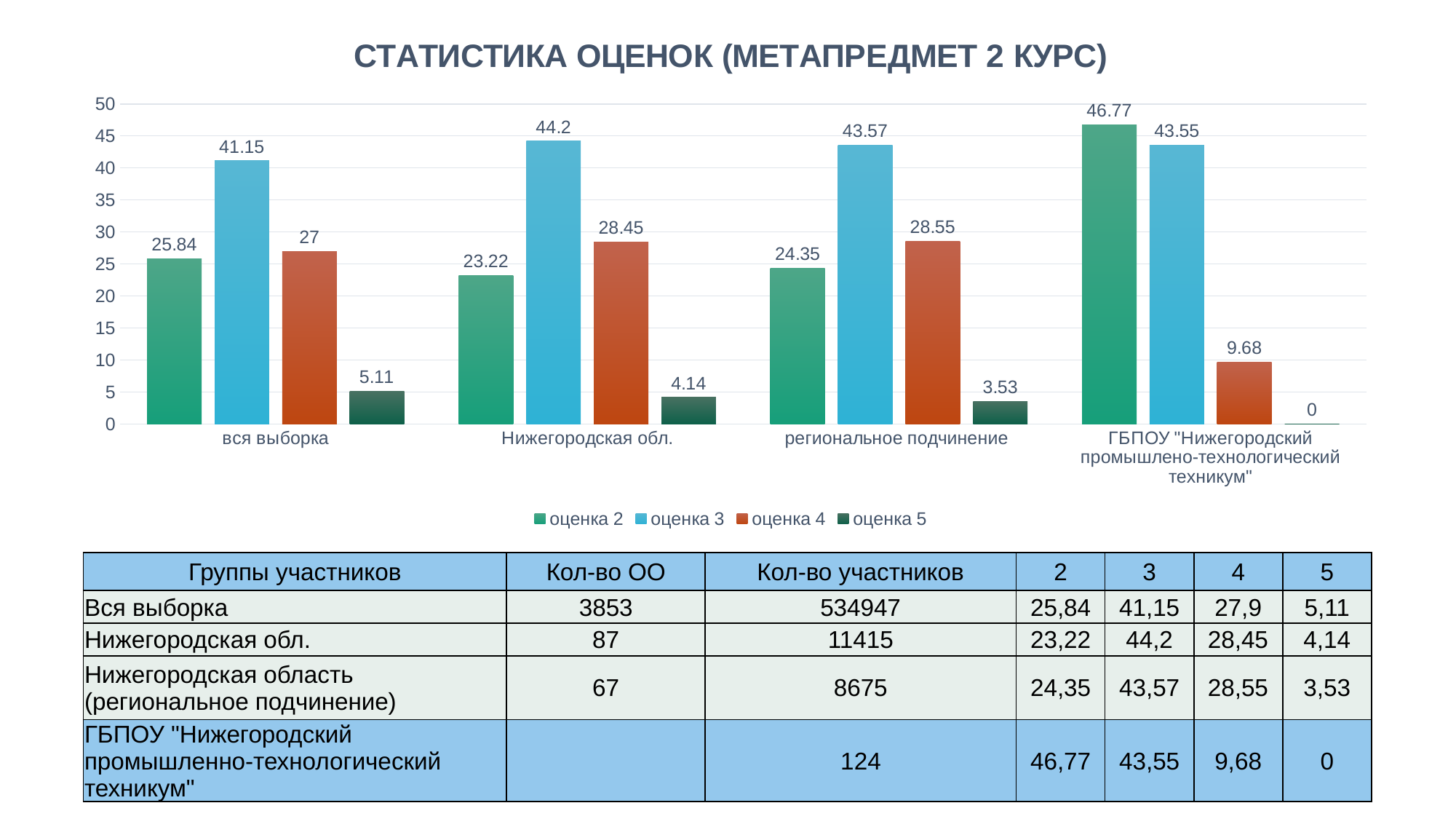
Which category has the highest value for оценка 2? ГБПОУ "Нижегородский промышлено-технологический техникум" What type of chart is shown on the slide? bar chart Which category has the lowest value for оценка 5? ГБПОУ "Нижегородский промышлено-технологический техникум" How many series does the legend list? 4 Which is larger for региональное подчинение: оценка 2 or оценка 4? оценка 4 How many categories are shown on the x axis? 4 Is the value of оценка 4 for ГБПОУ "Нижегородский промышлено-технологический техникум" greater or less than 10? less What is the value of оценка 3 for Нижегородская обл.? 44.2 What is the value of оценка 5 for региональное подчинение? 3.53 What is the difference between оценка 3 and оценка 2 for вся выборка? 15.31 What is the value of оценка 2 for ГБПОУ "Нижегородский промышлено-технологический техникум"? 46.77 What is the value of оценка 4 for вся выборка? 27